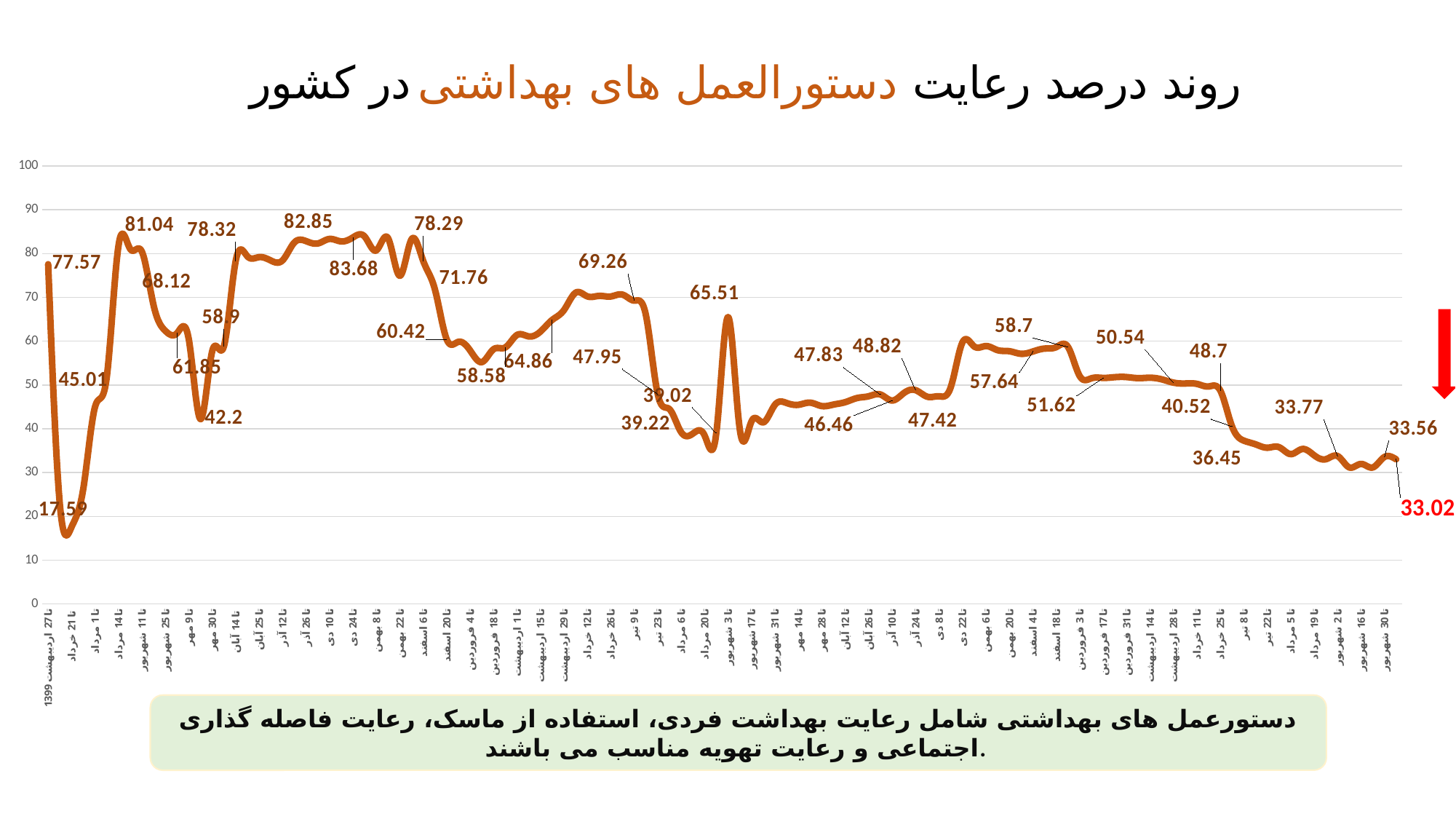
Which is larger, the labelled value 81.04 or the labelled value 78.32? 81.04 What is the value of the first point on the line (تا 27 اردیبهشت 1399)? 77.57 Which is larger, the labelled value 58.7 or the labelled value 50.54? 58.7 What is the difference between the first labelled value (77.57) and the lowest labelled value (17.59)? 59.98 Overall, does the line rise or fall from the first point to the last point? fall What is the lowest value labelled on the line? 17.59 What kind of chart is shown on the slide? line chart What is the difference between the labelled values 33.56 and 33.02 near the end of the line? 0.54 What is the difference between the labelled values 69.26 and 47.95? 21.31 What colour is the plotted line? orange How many lines are plotted on the chart? 1